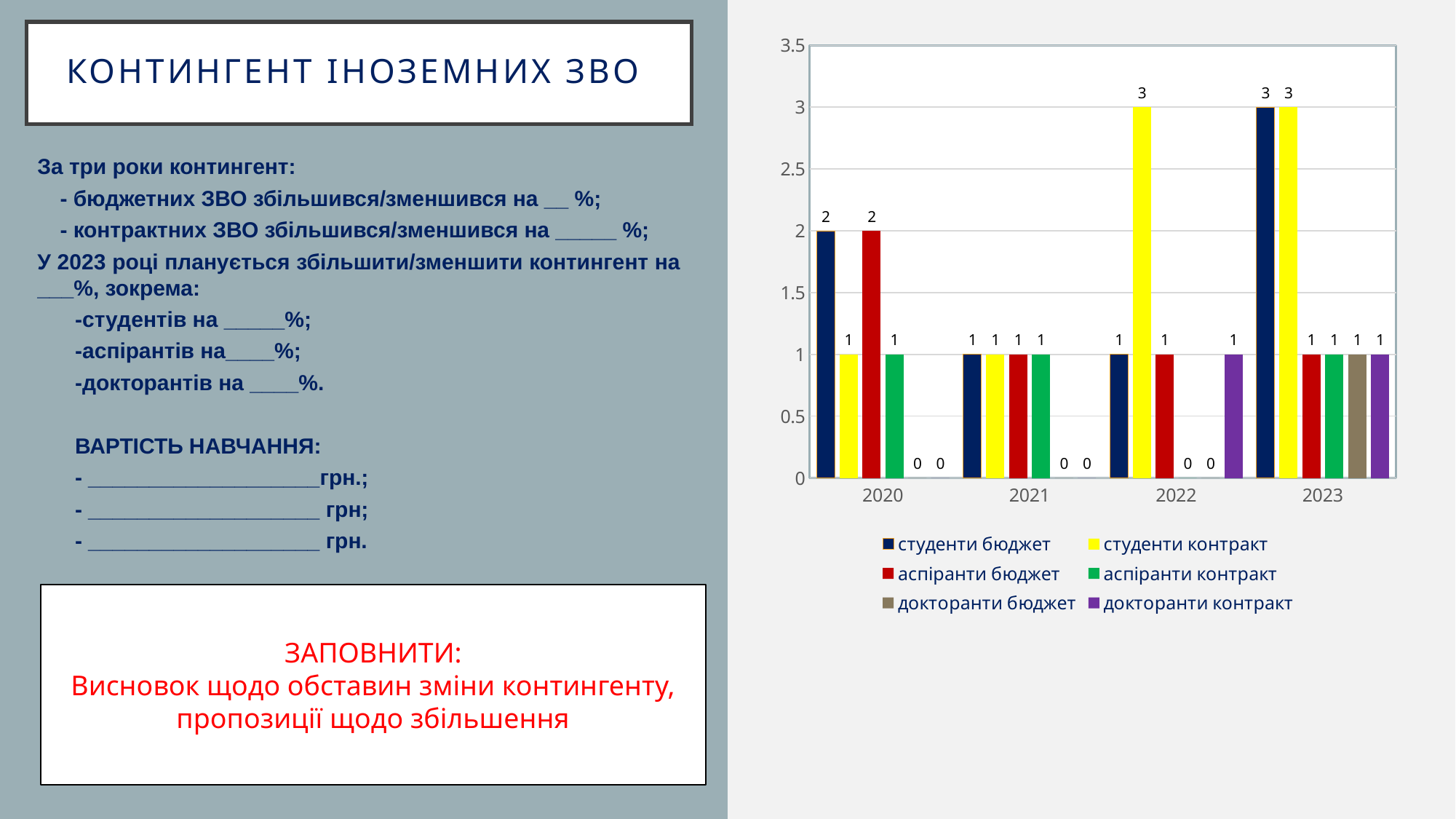
What kind of chart is shown on the slide? bar chart What is the difference between студенти контракт in 2022 and студенти контракт in 2021? 2 Which is larger in 2020: аспіранти бюджет or аспіранти контракт? аспіранти бюджет Does the value for студенти бюджет rise or fall from 2022 to 2023? rise What is the value for студенти бюджет in 2020? 2 What is the value for студенти контракт in 2022? 3 Which colour represents студенти контракт in the legend? yellow How many years are shown on the x axis? 4 How many series does the legend list? 6 What is the value for аспіранти контракт in 2022? 0 In which year is the value for студенти бюджет highest? 2023 What is the value for докторанти бюджет in 2023? 1